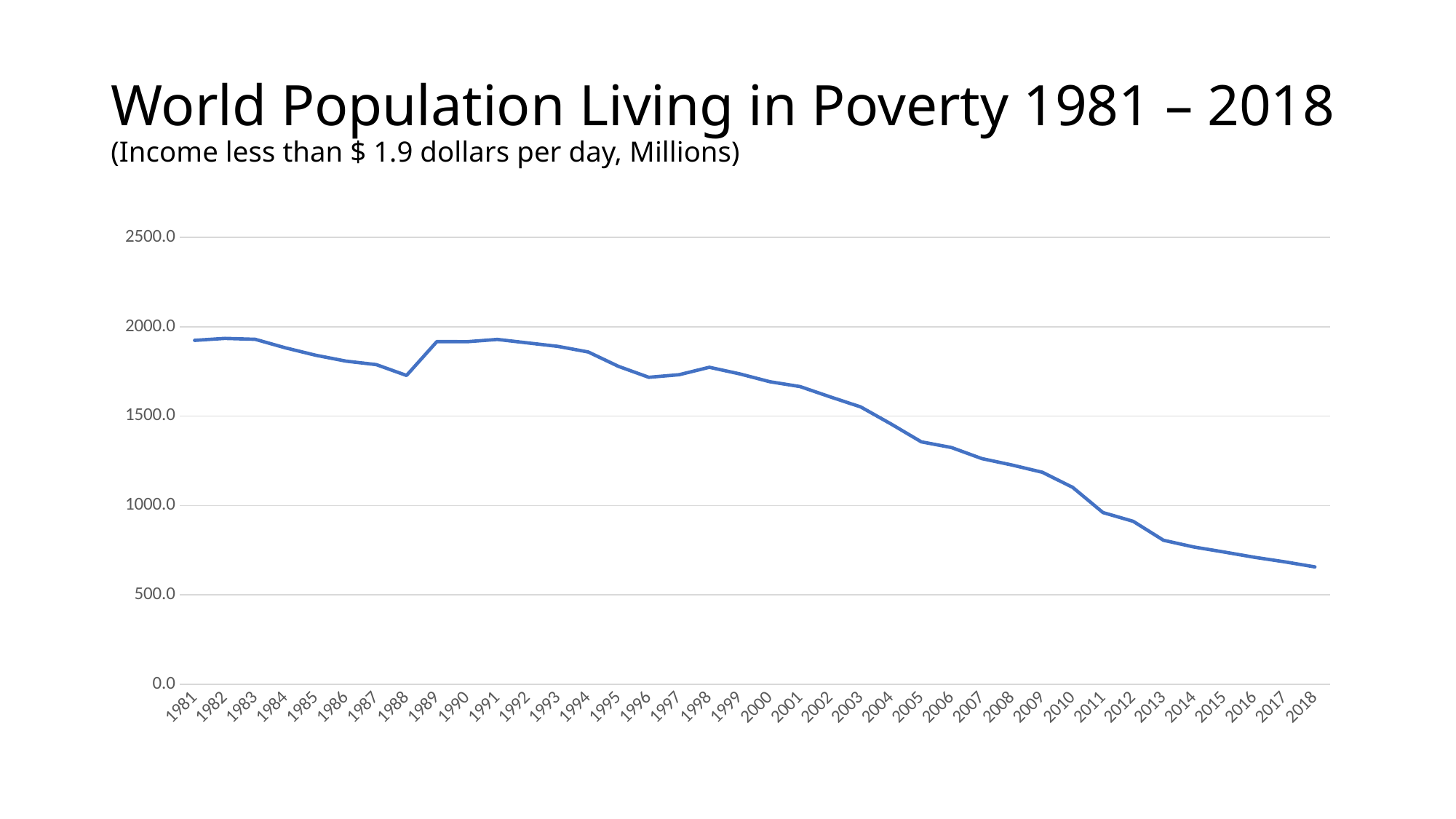
What kind of chart is shown on the slide? line chart Is the value for 1981 greater or less than 1500? greater Do the values generally rise or fall from 1981 to 2018? fall How many years are plotted along the x axis? 38 What is the title of the chart? World Population Living in Poverty 1981 – 2018 Which year has the larger value, 1988 or 1989? 1989 Which year has the larger value, 2003 or 2005? 2003 Is the value for 2013 greater or less than 1000? less Is the value for 2018 greater or less than 1000? less Which year has the lowest value on the chart? 2018